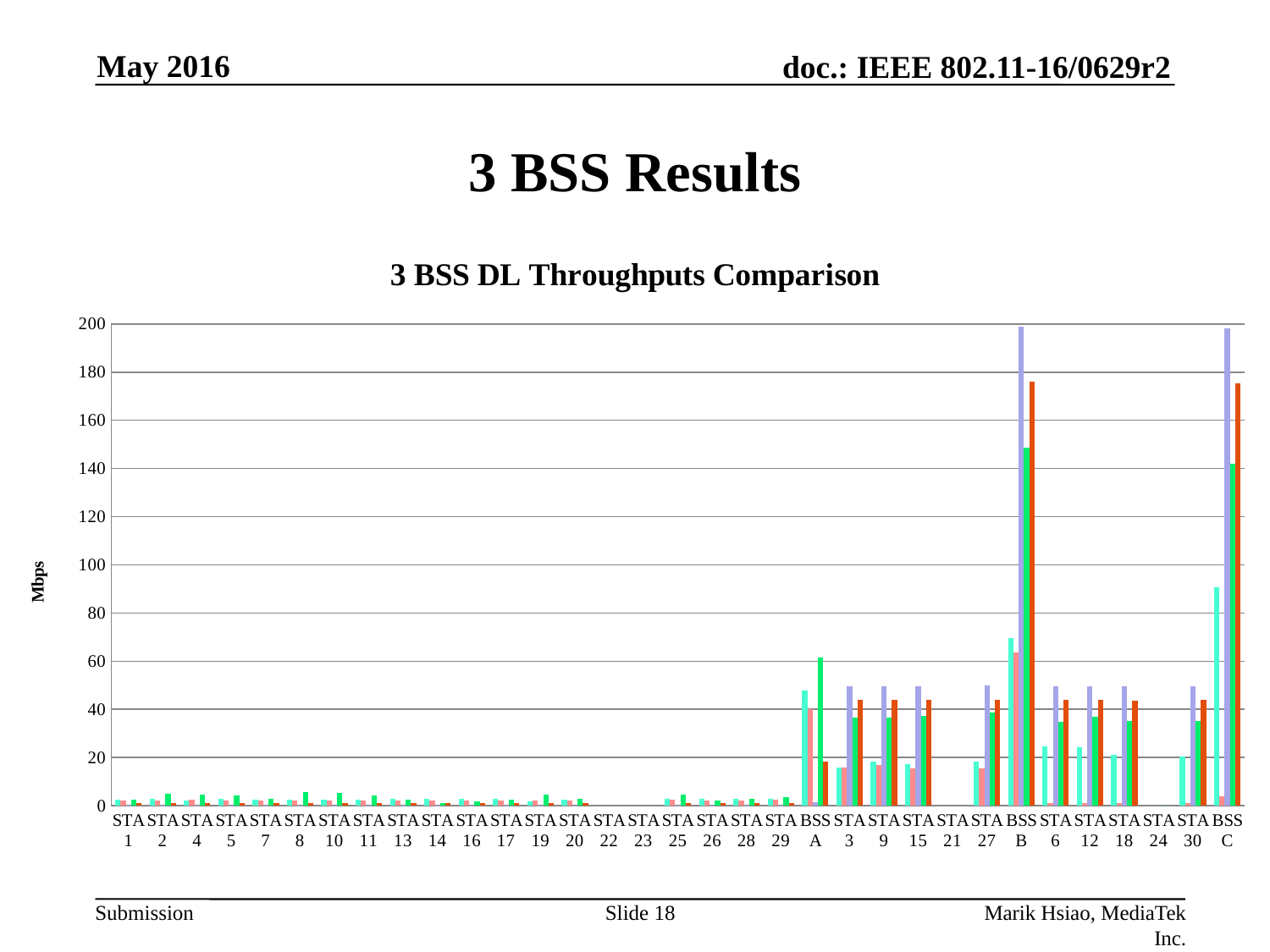
What is the title of the chart? 3 BSS DL Throughputs Comparison What is the highest value shown on the vertical axis? 200 Is the tallest bar for BSS A greater or less than 80? less Which has taller bars, BSS A or BSS B? BSS B Is the tallest bar for BSS B greater or less than 180? greater Is the tallest bar for STA 3 greater or less than 40? greater How many BSS categories (BSS A, BSS B, BSS C) appear on the x axis? 3 What unit is shown on the vertical axis label of the chart? Mbps Which has taller bars, STA 1 or BSS C? BSS C What kind of chart is shown on the slide? bar chart